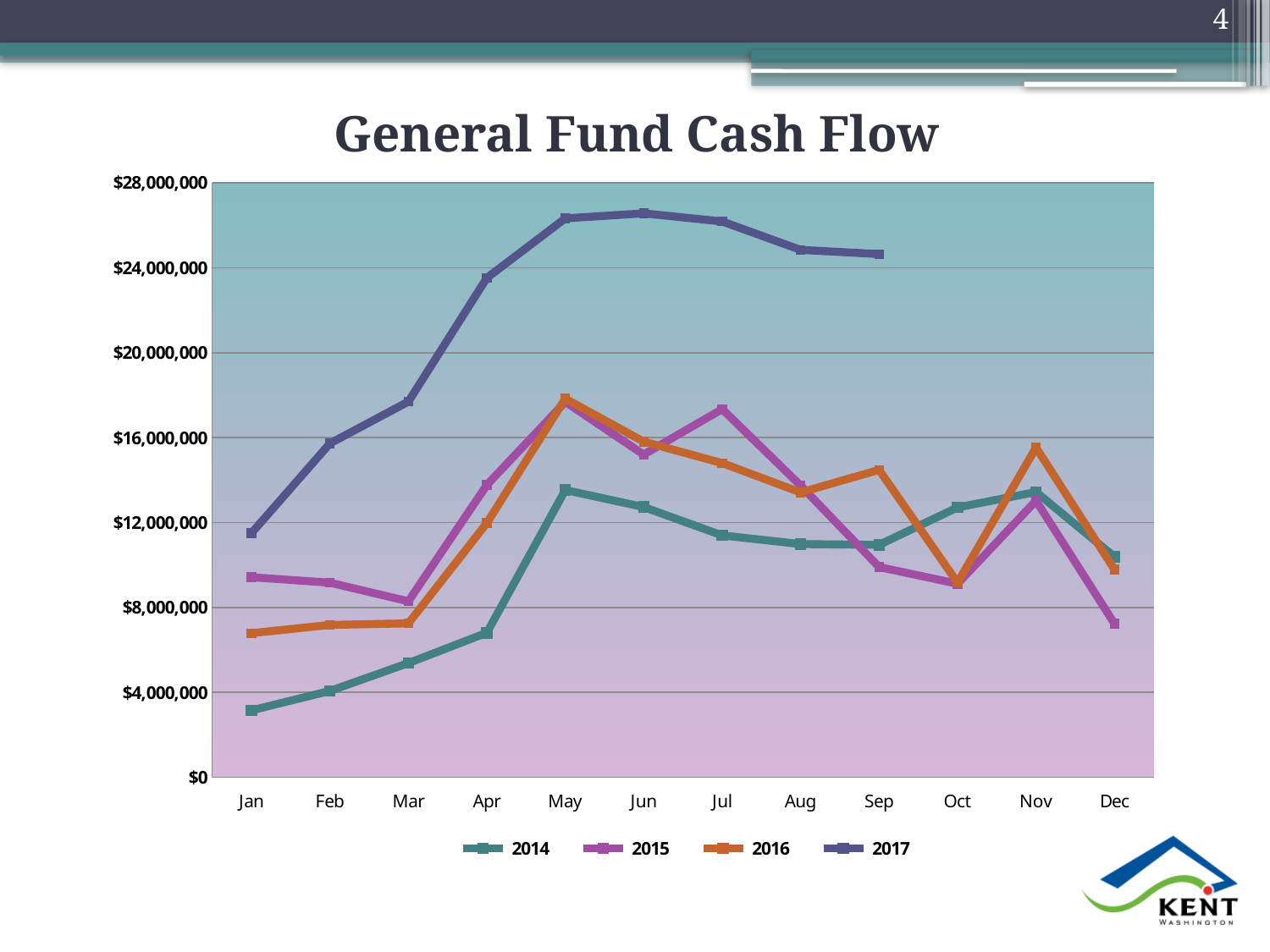
Is the value for 2014 in Jan greater or less than $4,000,000? less Which series has the highest value in May? 2017 Is the value for 2016 in May greater or less than $16,000,000? greater What is the title of the chart? General Fund Cash Flow What kind of chart is shown on the slide? line chart How many months are shown along the x axis? 12 Is the value for 2017 in Apr greater or less than $20,000,000? greater In which month is the 2015 series at its lowest? Dec In Nov, which is larger: the value for 2016 or the value for 2015? 2016 How many series does the legend list? 4 Does the 2017 series rise or fall from Jan to May? rise Which series has data plotted only through Sep? 2017